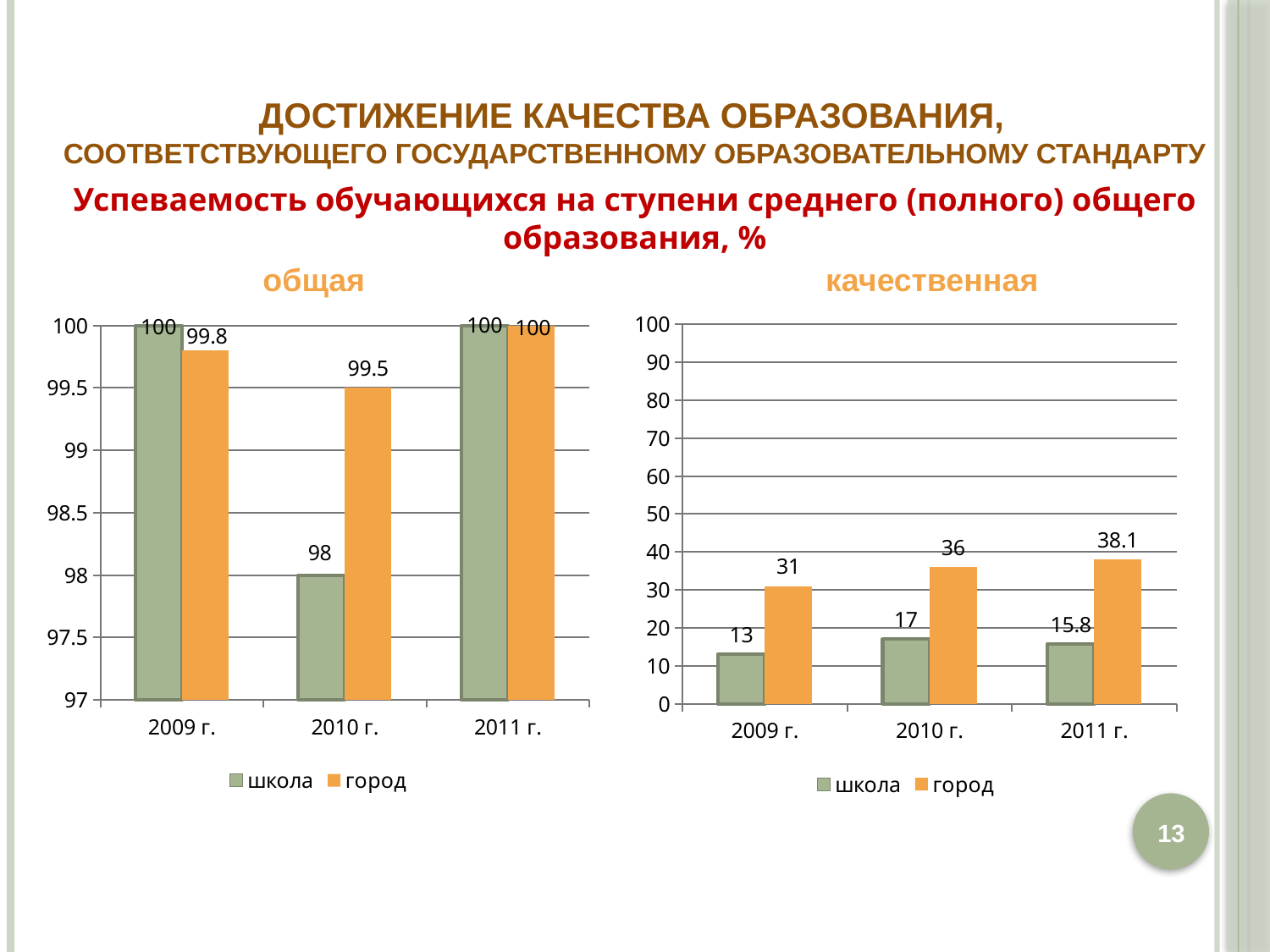
What kind of chart is the left chart (общая)? bar chart In the left chart (общая), what is the value for город in 2009 г.? 99.8 In the right chart (качественная), how many series does the legend list? 2 In the right chart (качественная), what is the difference between город and школа in 2010 г.? 19 In the right chart (качественная), which year has the highest value for школа? 2010 г. In the right chart (качественная), what is the value for школа in 2009 г.? 13 In the right chart (качественная), which is larger in 2011 г., школа or город? город In the right chart (качественная), does the value for город rise or fall from 2009 г. to 2011 г.? rise In the left chart (общая), which year has the lowest value for город? 2010 г. In the right chart (качественная), what is the value for город in 2011 г.? 38.1 In the left chart (общая), what is the value for школа in 2010 г.? 98 In the left chart (общая), what is the difference between город and школа in 2010 г.? 1.5